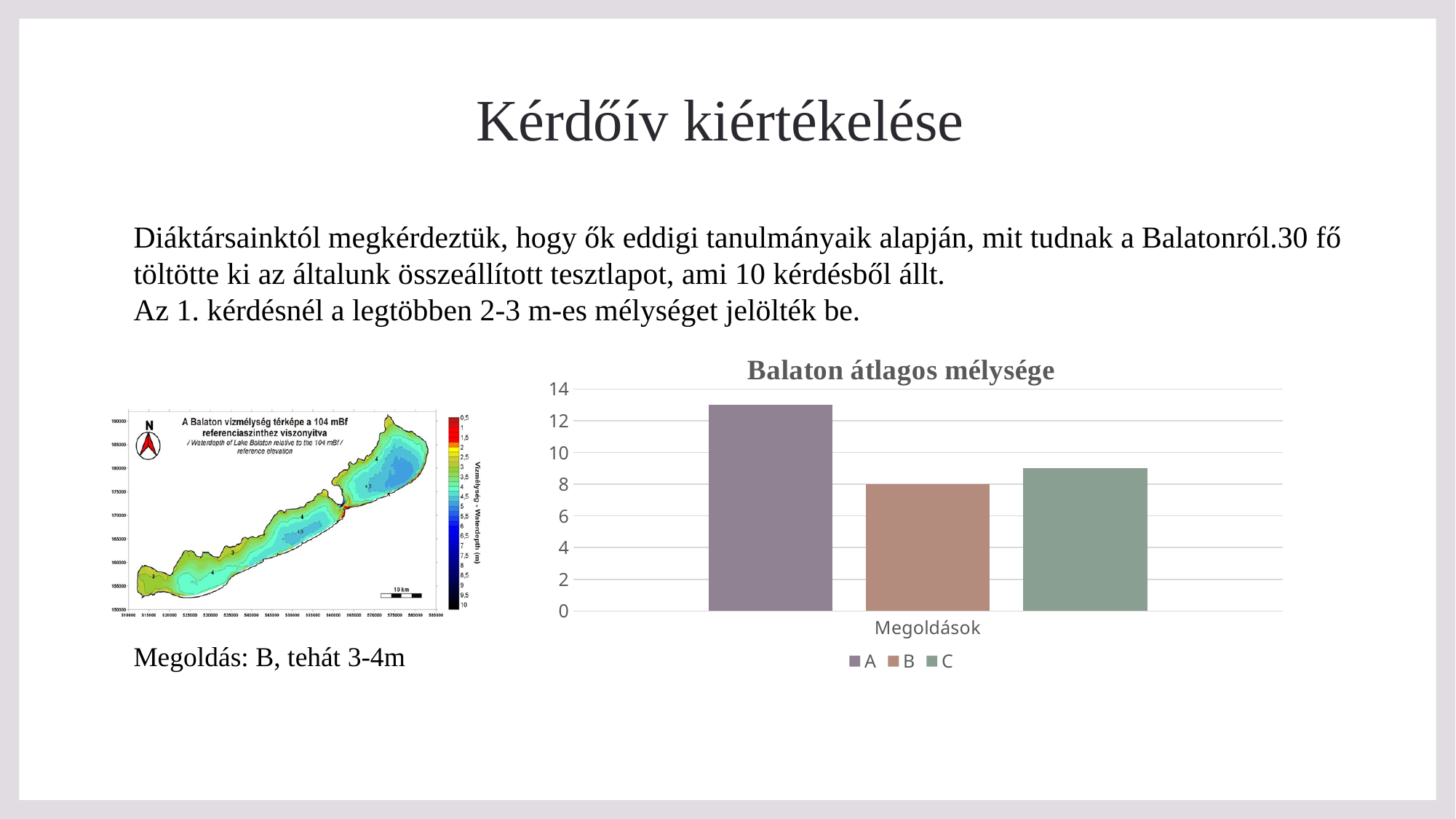
Is the value for C greater or less than 8? greater What is the title of the chart on the slide? Balaton átlagos mélysége How many categories are shown on the x axis of the chart? 1 Is the value for C greater or less than 10? less Which series has the lowest value in the chart? B What is the value for series B in the chart? 8 Which is larger in the chart, the value for B or the value for C? C What kind of chart is shown on the slide? bar chart Is the value for A greater or less than 12? greater How many series does the chart's legend list? 3 Which series has the highest value in the chart? A What is the label of the category on the x axis of the chart? Megoldások